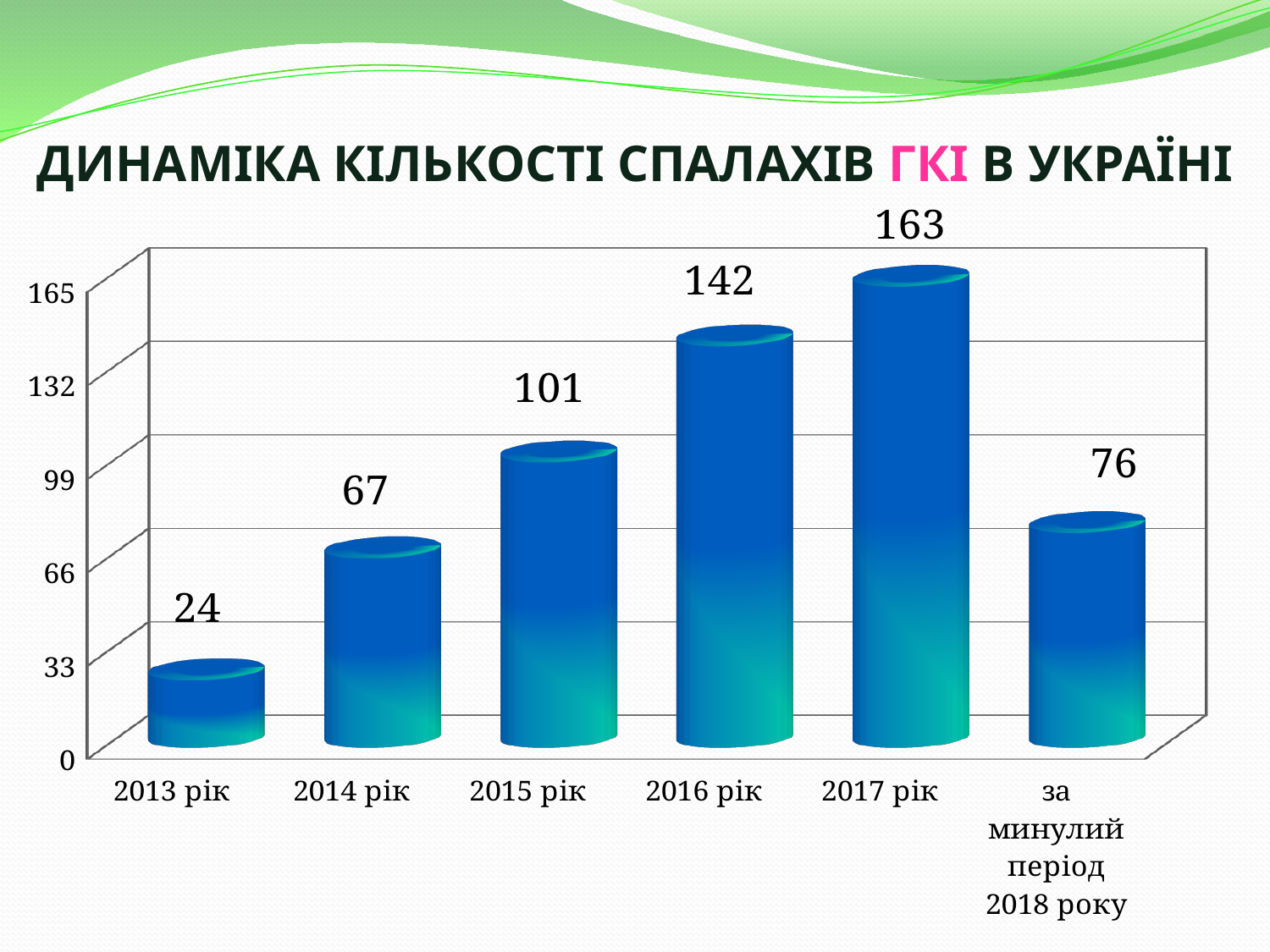
Do the values rise or fall from 2013 рік to 2017 рік? rise What kind of chart is shown on the slide? bar chart What is the value for 2016 рік? 142 Which is larger, the value for 2015 рік or the value for за минулий період 2018 року? 2015 рік What is the value for 2013 рік? 24 How many categories are shown on the x axis? 6 Which category has the highest value? 2017 рік What is the value for за минулий період 2018 року? 76 What is the difference between the values for 2017 рік and 2016 рік? 21 What is the difference between the values for 2015 рік and 2014 рік? 34 Which category has the lowest value? 2013 рік Is the value for 2014 рік greater or less than 99? less